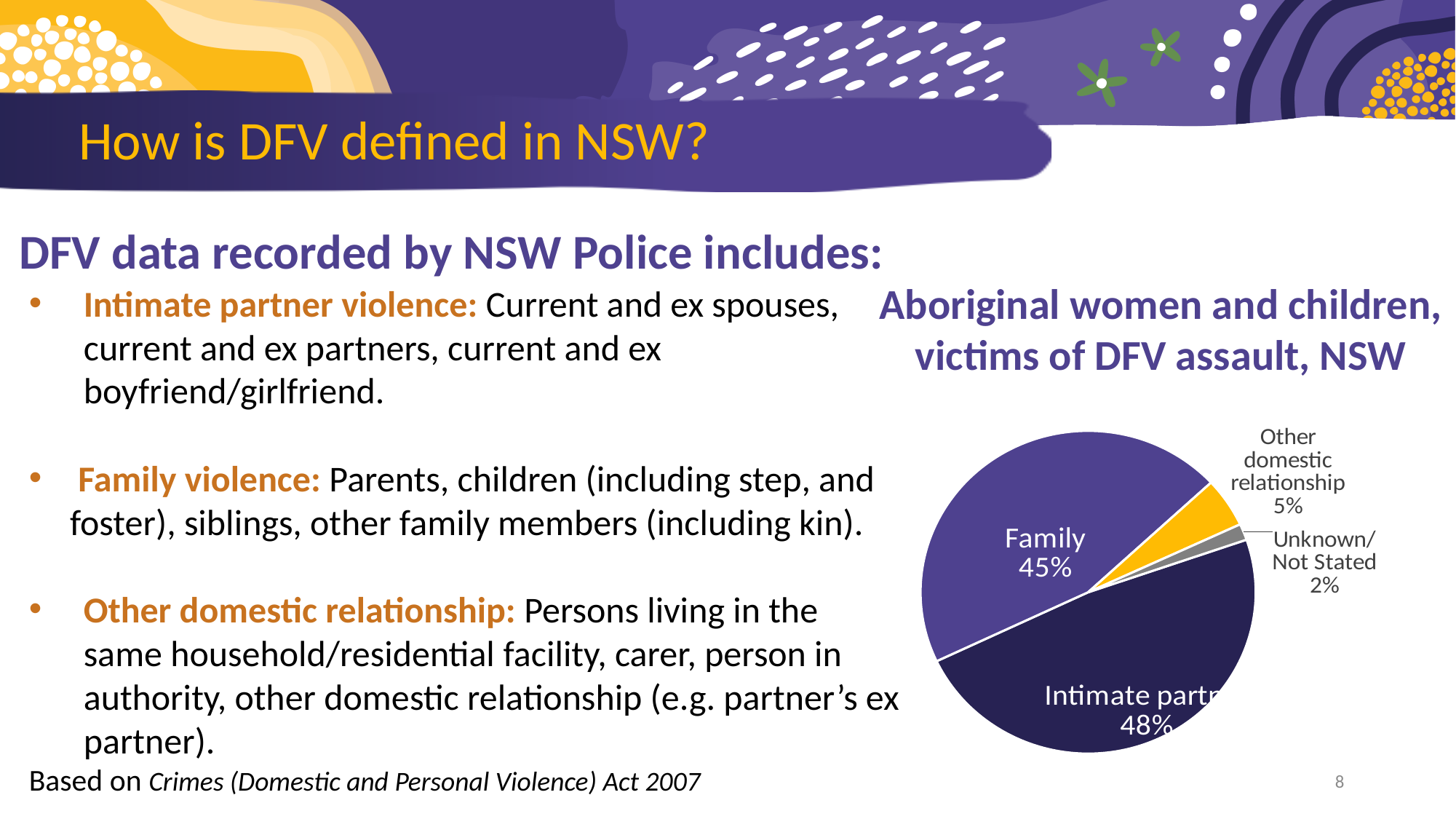
Which slice of the pie is the largest? Intimate partner Which slice of the pie is the smallest? Unknown/Not Stated What share of the pie is labelled Unknown/Not Stated? 2% What is the title of the chart on the slide? Aboriginal women and children, victims of DFV assault, NSW What share of the pie is labelled Family? 45% Which is larger, the Other domestic relationship slice or the Unknown/Not Stated slice? Other domestic relationship What colour is the Other domestic relationship slice of the pie? Yellow What is the difference in percentage points between the Intimate partner and Family slices? 3 percentage points What kind of chart is shown on the slide? Pie chart What share of the pie is labelled Other domestic relationship? 5% What share of the pie is labelled Intimate partner? 48% How many slices does the pie chart have? 4